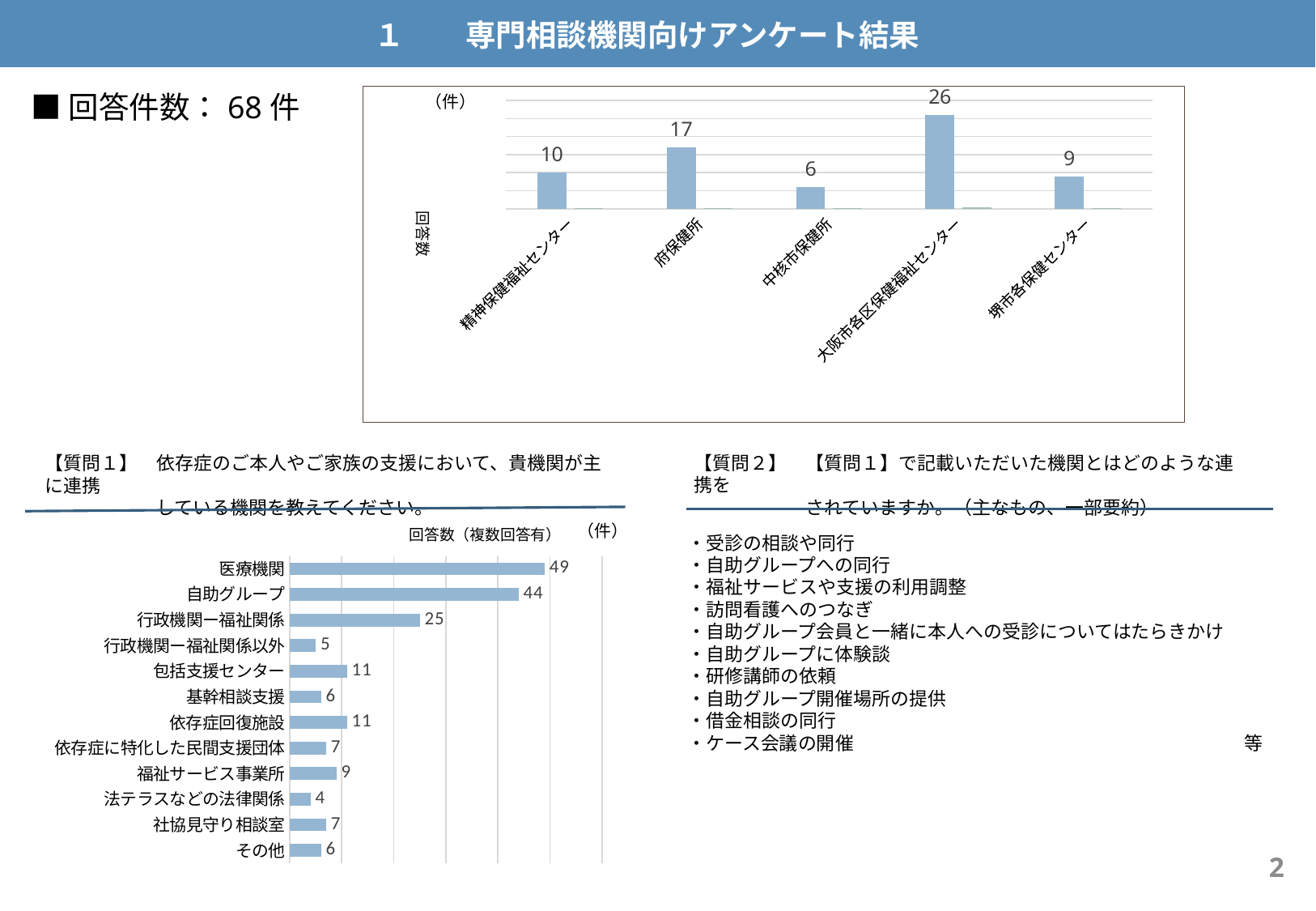
What type of chart is the bottom-left chart (質問1, 回答数（複数回答有）)? Bar chart In the top chart (回答数 by institution), what is the difference between 大阪市各区保健福祉センター and 精神保健福祉センター? 16 In the top chart (回答数 by institution), which category has the lowest value? 中核市保健所 In the bottom-left chart (質問1, 回答数（複数回答有）), what is the difference between 医療機関 and 行政機関ー福祉関係? 24 In the bottom-left chart (質問1, 回答数（複数回答有）), which category has the highest value? 医療機関 In the top chart (回答数 by institution), what is the value for 府保健所? 17 In the top chart (回答数 by institution), which category has the highest value? 大阪市各区保健福祉センター In the bottom-left chart (質問1, 回答数（複数回答有）), what is the value for 自助グループ? 44 In the top chart (回答数 by institution), how many categories are shown? 5 In the bottom-left chart (質問1, 回答数（複数回答有）), which category has the lowest value? 法テラスなどの法律関係 In the bottom-left chart (質問1, 回答数（複数回答有）), which is larger, 包括支援センター or 福祉サービス事業所? 包括支援センター In the bottom-left chart (質問1, 回答数（複数回答有）), how many categories are shown? 12